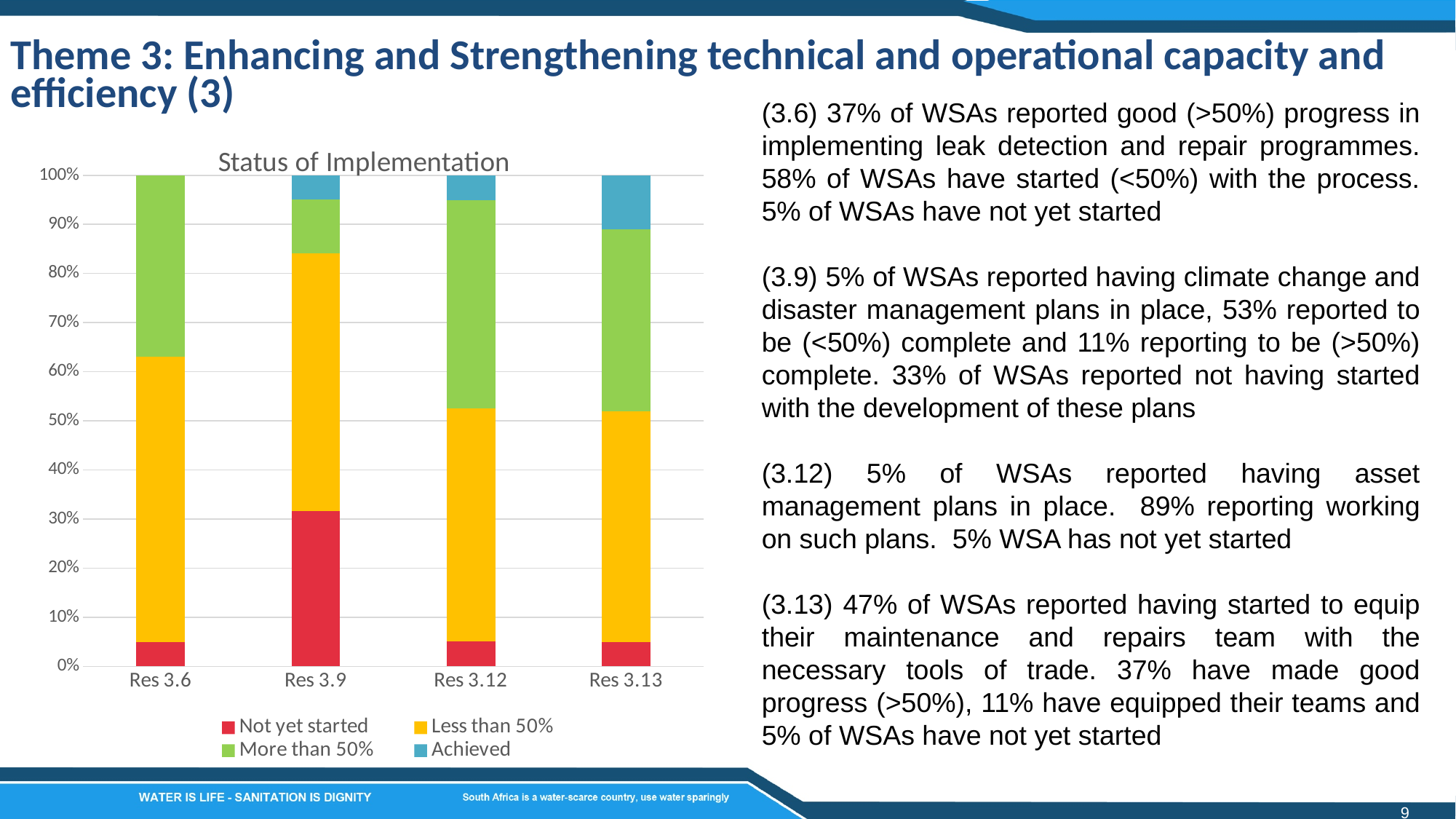
How many categories are shown on the x axis of the chart? 4 Which category has the largest Achieved segment? Res 3.13 What kind of chart is shown on the slide? stacked bar chart How many series does the chart legend list? 4 What is the title of the chart? Status of Implementation Is the Not yet started value for Res 3.9 greater or less than 20%? greater Which category has the largest Not yet started segment? Res 3.9 What is the total of the stacked bar for Res 3.6? 100% Which category has no Achieved segment at all? Res 3.6 Is the Not yet started segment larger for Res 3.9 or for Res 3.6? Res 3.9 Is the Not yet started value for Res 3.6 greater or less than 10%? less Which series is shown in red in the chart? Not yet started